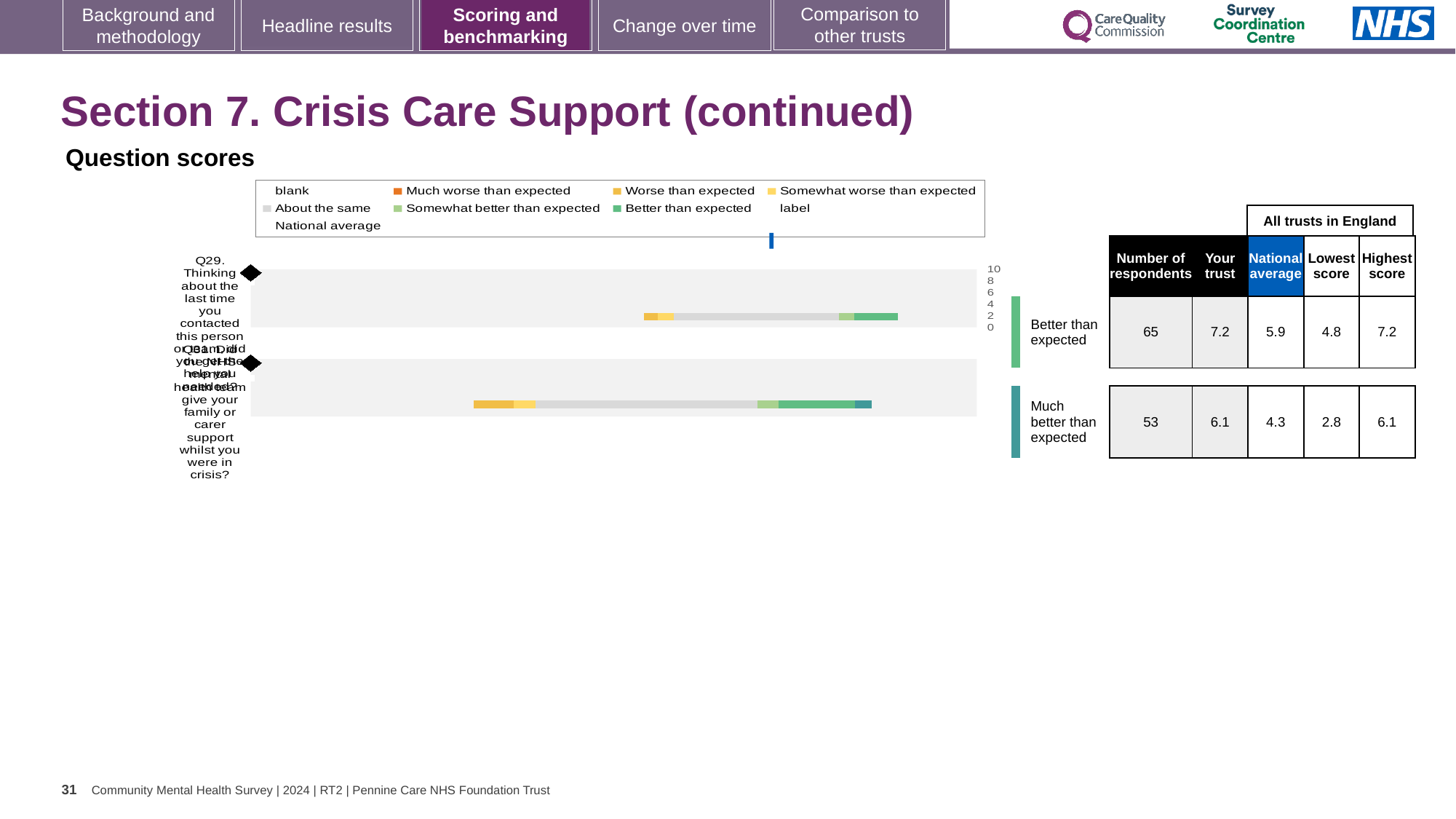
How many respondents answered Q31? 53 What is the 'Your trust' score for Q31 (Did the NHS mental health team give your family or carer support whilst you were in crisis?)? 6.1 What is the national average score for Q31? 4.3 What is the lowest score among all trusts in England for Q29? 4.8 What kind of chart is shown under 'Question scores'? bar chart What benchmark category is shown for Q31? Much better than expected How many questions (categories) are plotted in the chart? 2 What is the difference between the 'Your trust' score and the national average for Q29? 1.3 What is the national average score for Q29? 5.9 What is the 'Your trust' score for Q29 (Thinking about the last time you contacted this person or team, did you get the help you needed?)? 7.2 Which question has the higher 'Your trust' score, Q29 or Q31? Q29 What is the difference between the 'Your trust' score and the national average for Q31? 1.8